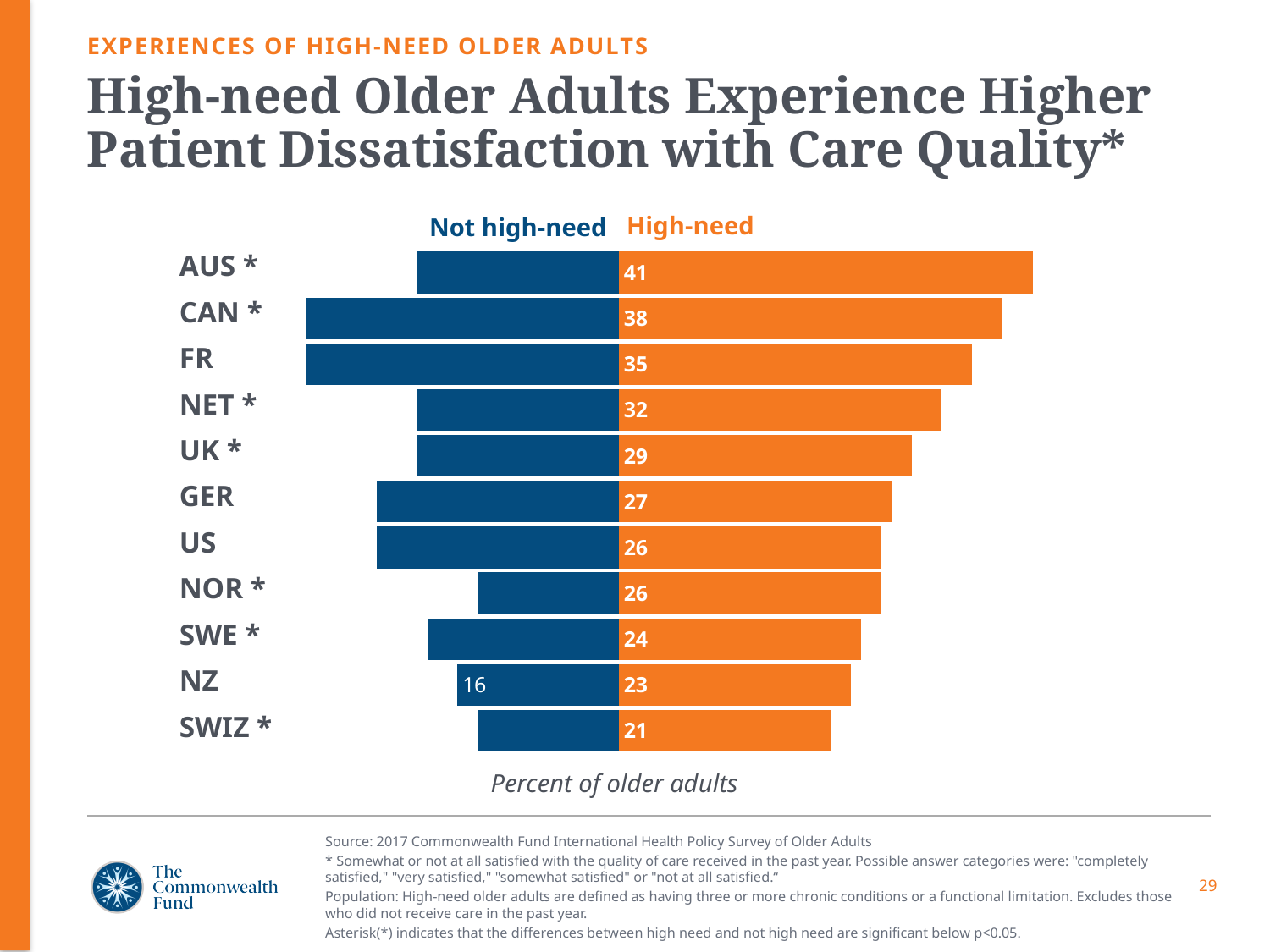
What is the High-need value for AUS? 41 How many countries are shown in the chart? 11 What is the High-need value for NZ? 23 What is the difference between the High-need values for AUS and CAN? 3 What kind of chart is shown on the slide? Bar chart Which country has the highest High-need value? AUS How many series does the chart show? 2 Which is larger, the Not high-need bar for CAN or the Not high-need bar for NZ? CAN For NZ, what is the difference between the High-need and Not high-need values? 7 Which country has the lowest High-need value? SWIZ What colour are the High-need bars? Orange What is the Not high-need value for NZ? 16